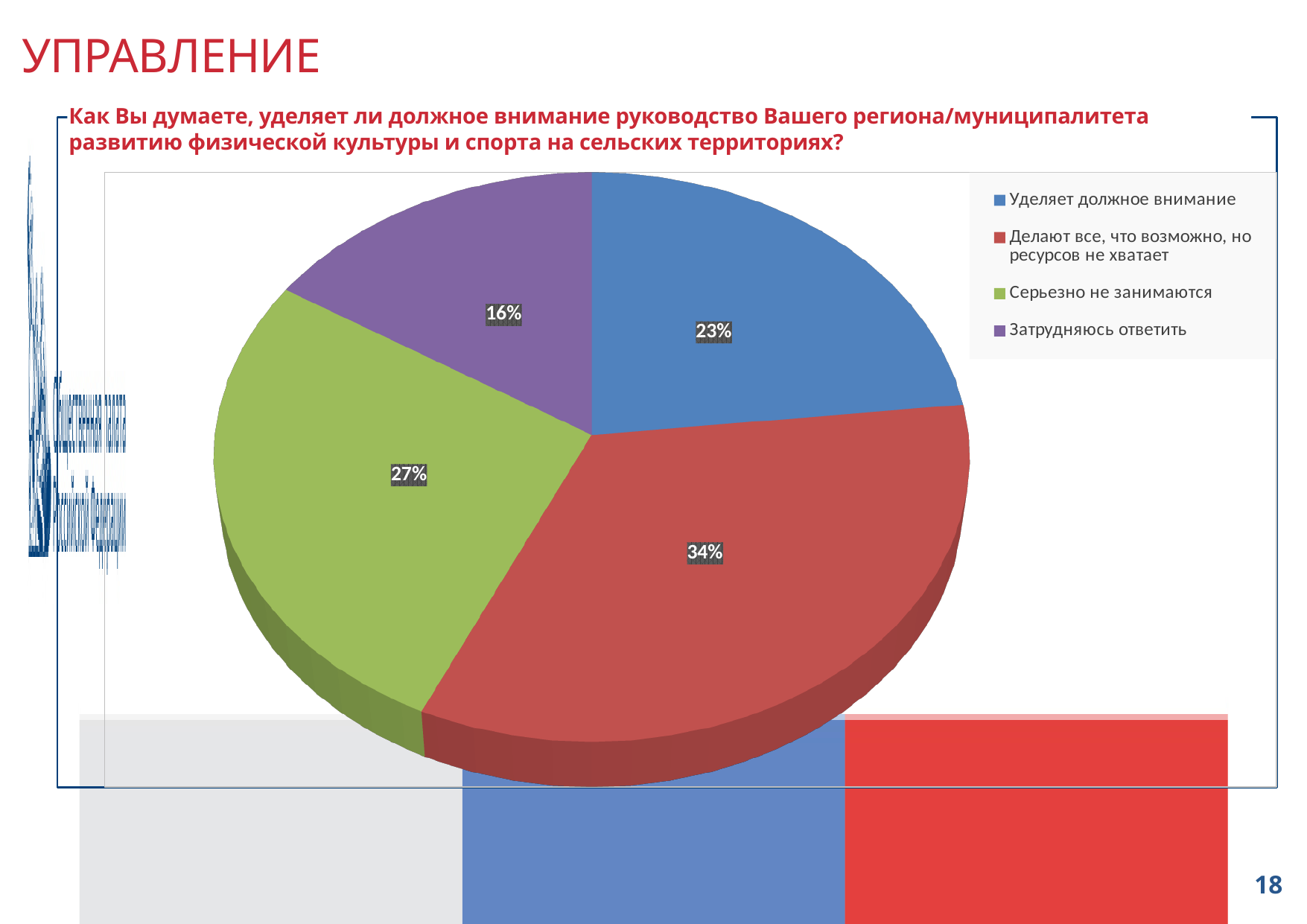
How many entries does the legend list? 4 What share of respondents answered "Делают все, что возможно, но ресурсов не хватает"? 34% What is the difference in percentage points between "Делают все, что возможно, но ресурсов не хватает" and "Уделяет должное внимание"? 11 Which answer option has the smallest share of the pie? Затрудняюсь ответить What share of respondents answered "Серьезно не занимаются"? 27% Which is larger: the share for "Серьезно не занимаются" or the share for "Уделяет должное внимание"? Серьезно не занимаются Which answer option has the largest share of the pie? Делают все, что возможно, но ресурсов не хватает What type of chart is shown on the slide? pie chart What share of respondents answered "Затрудняюсь ответить"? 16% What colour is the slice for "Серьезно не занимаются"? green How many slices does the pie chart have? 4 What share of respondents answered "Уделяет должное внимание"? 23%